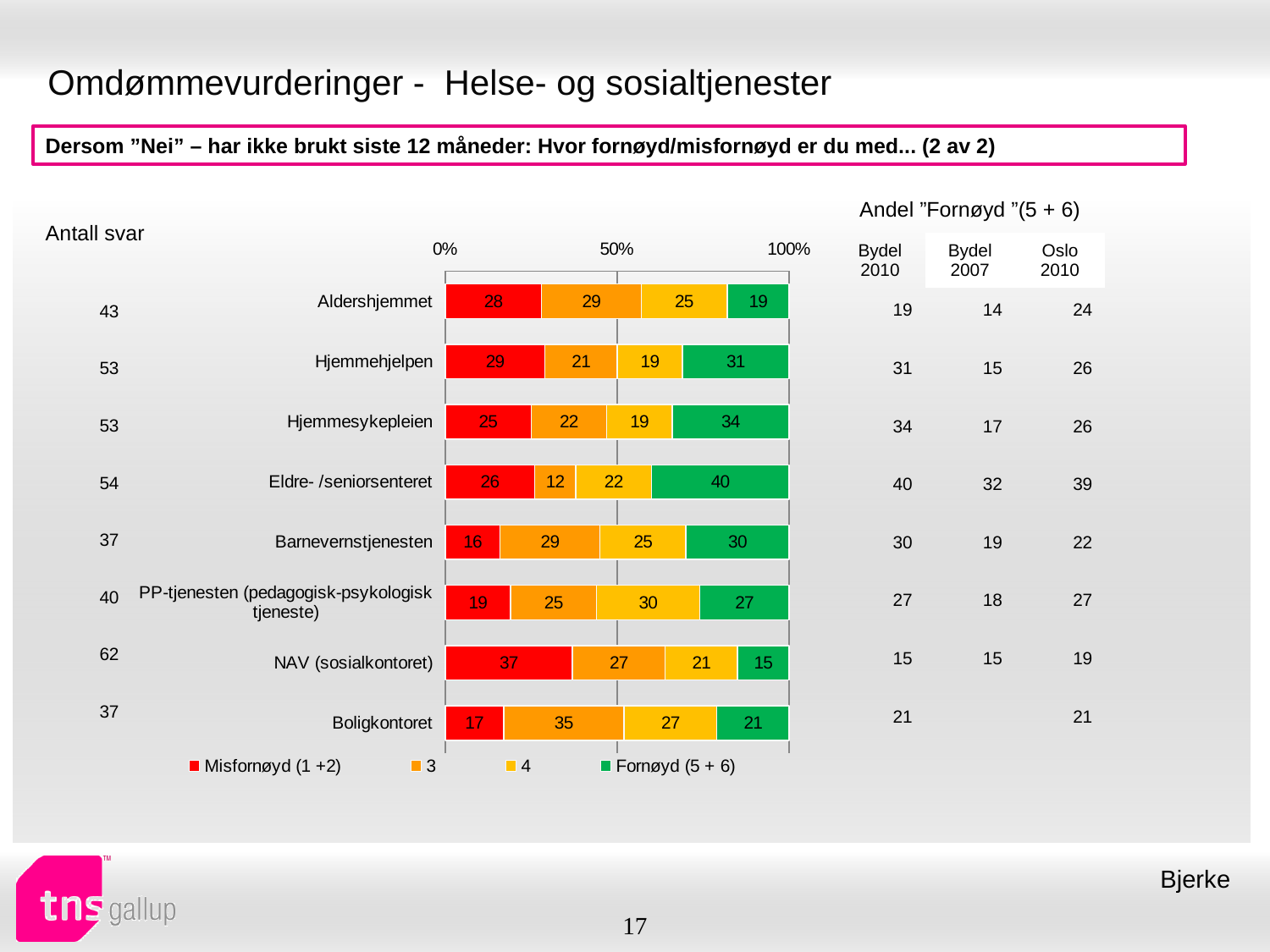
Which has the larger Misfornøyd (1 +2) value, NAV (sosialkontoret) or Boligkontoret? NAV (sosialkontoret) How many categories are shown in the chart? 8 What is the value of the Misfornøyd (1 +2) segment for NAV (sosialkontoret)? 37 Which category has the highest Fornøyd (5 + 6) value? Eldre- /seniorsenteret Which category has the highest Misfornøyd (1 +2) value? NAV (sosialkontoret) What is the total of the stacked bar for Boligkontoret? 100 What type of chart is shown? Stacked bar chart How many series does the legend list? 4 Which category has the lowest Fornøyd (5 + 6) value? NAV (sosialkontoret) What is the difference between the Fornøyd (5 + 6) values for Hjemmesykepleien and Aldershjemmet? 15 What is the value of the Fornøyd (5 + 6) segment for Eldre- /seniorsenteret? 40 What is the value of the '3' segment for Boligkontoret? 35